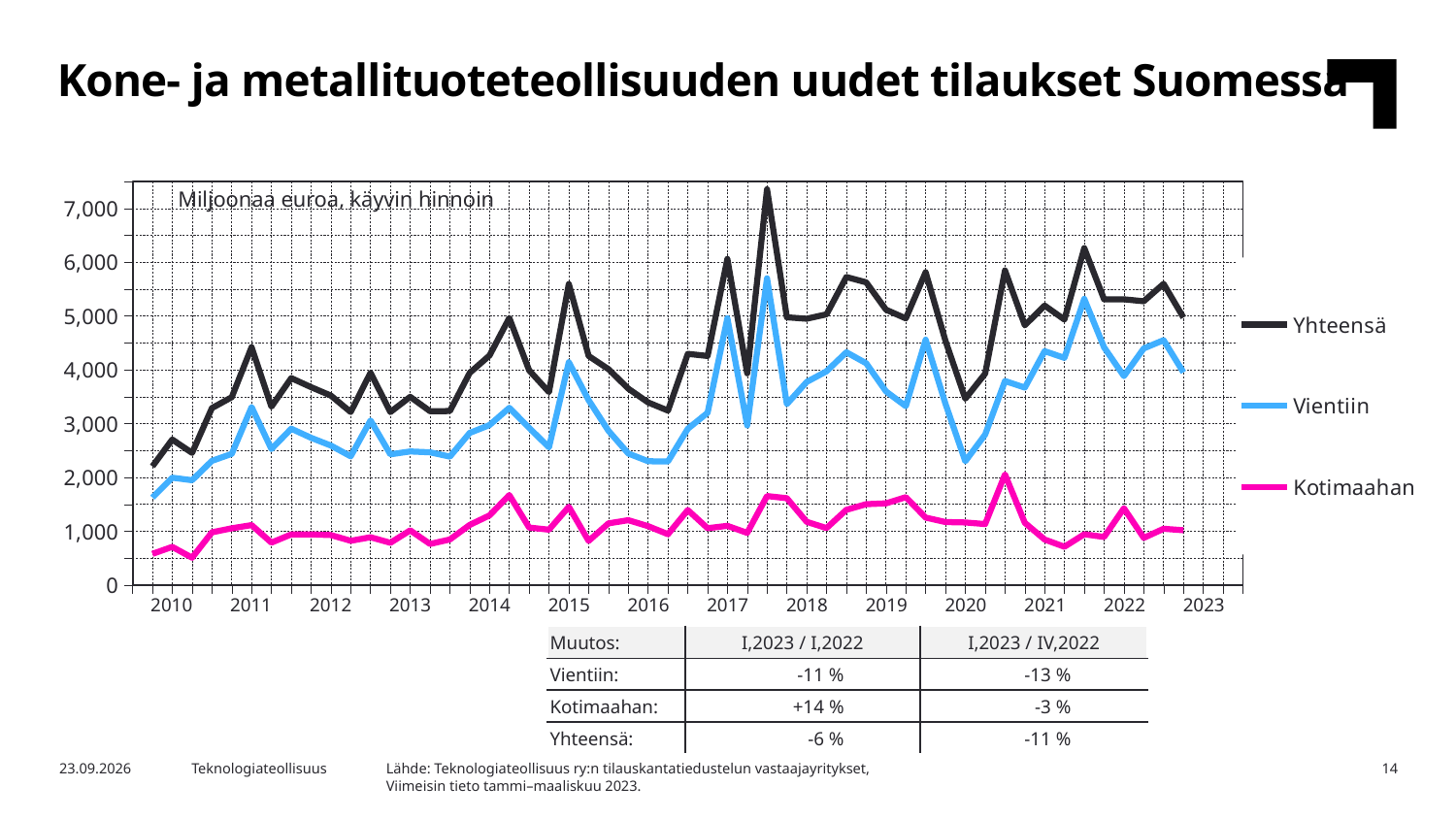
How many series does the chart legend list? 3 What is the title of the chart on the slide? Kone- ja metallituoteteollisuuden uudet tilaukset Suomessa What are the three series named in the chart legend? Yhteensä, Vientiin, Kotimaahan Which series is larger in 2017, Vientiin or Kotimaahan? Vientiin Is the value of the Kotimaahan series ever greater or less than 3,000? less Is the highest peak of the Vientiin series greater or less than 5,000? greater In which year does the Yhteensä series reach its highest peak? 2017 Which series has the lowest values throughout the chart? Kotimaahan Which series has the highest values throughout the chart? Yhteensä Does the Yhteensä series generally rise or fall from 2010 to 2022? rise Is the highest peak of the Yhteensä series greater or less than 7,000? greater What kind of chart is shown on the slide? line chart